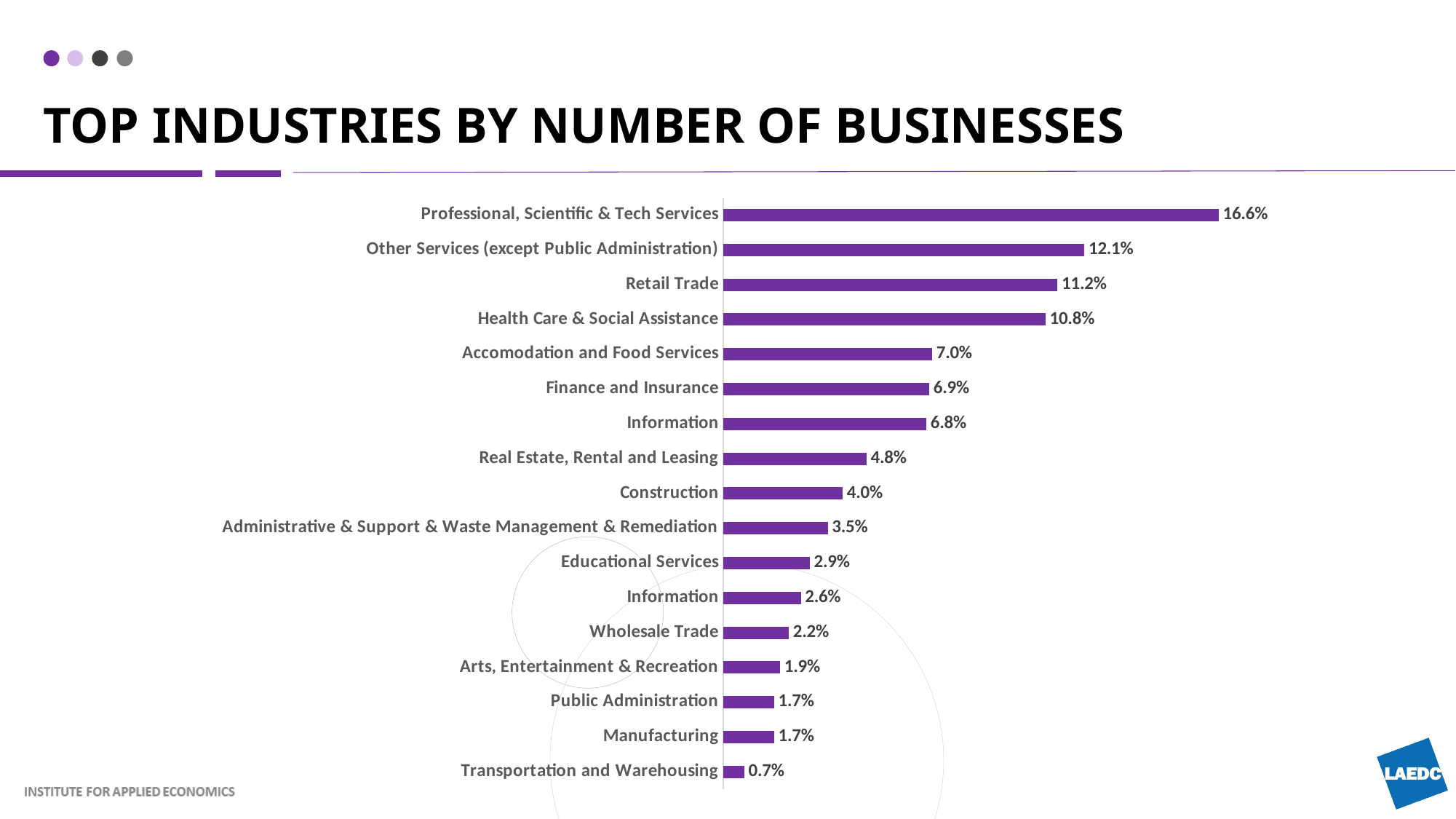
What is the value for Construction? 4.0% What is the value for Wholesale Trade? 2.2% What is the title of the slide? TOP INDUSTRIES BY NUMBER OF BUSINESSES Which industry has the lowest share of businesses? Transportation and Warehousing What is the difference between Professional, Scientific & Tech Services and Other Services (except Public Administration)? 4.5% Which industry has the highest share of businesses? Professional, Scientific & Tech Services Which is larger, Educational Services or Arts, Entertainment & Recreation? Educational Services How many industries are shown in the chart? 17 What is the value for Health Care & Social Assistance? 10.8% What is the value for Retail Trade? 11.2% What is the difference between Accomodation and Food Services and Real Estate, Rental and Leasing? 2.2% What kind of chart is shown on the slide? Bar chart